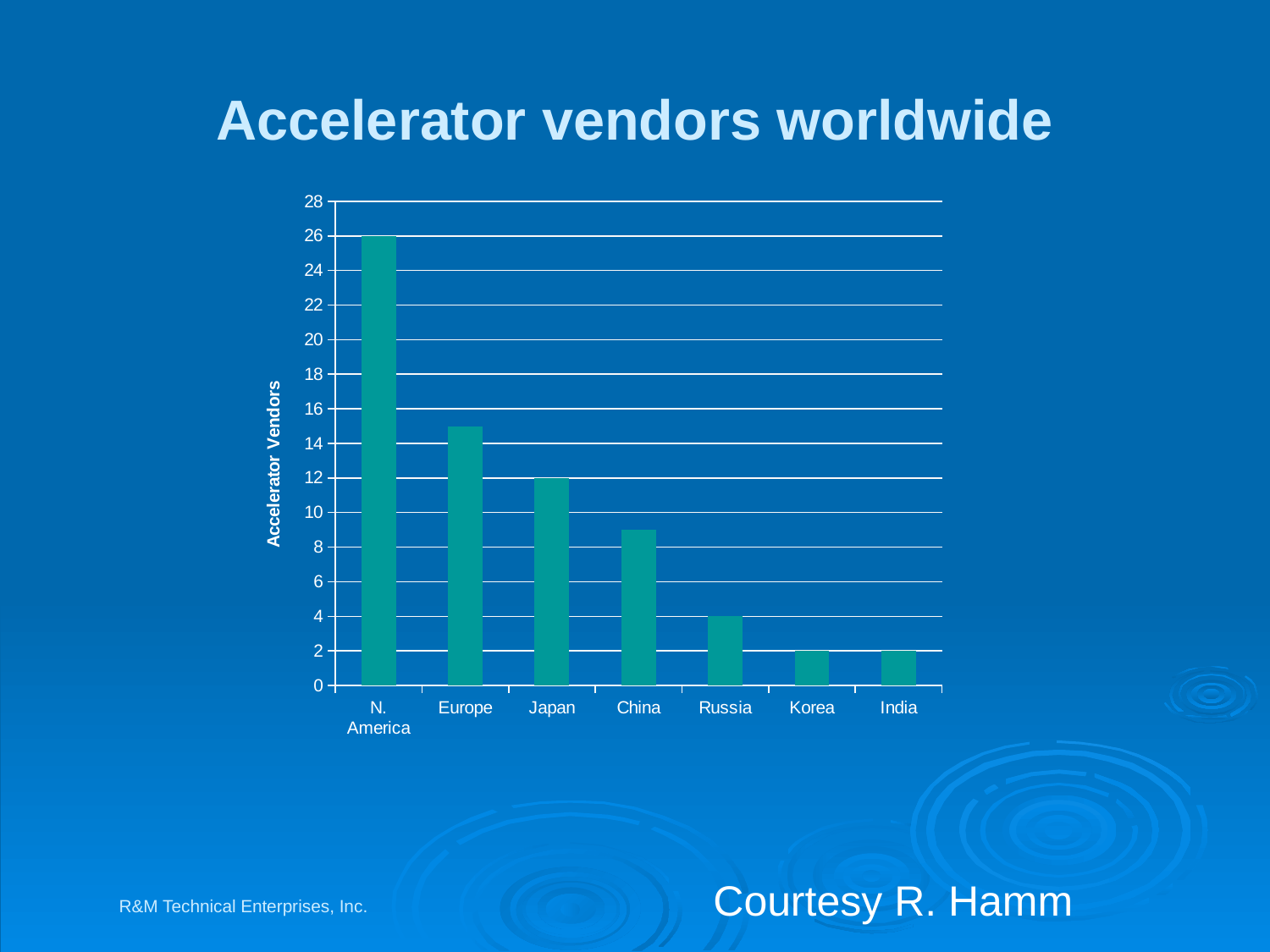
Do the values generally rise or fall moving from left to right along the x axis? fall Which region has the highest number of accelerator vendors? N. America How many accelerator vendors does Japan have? 12 How many accelerator vendors does N. America have? 26 What is the label on the y axis of the chart? Accelerator Vendors How many accelerator vendors does Russia have? 4 Which has more accelerator vendors, Europe or Japan? Europe Is the value for China greater or less than 10? less Is the value for Europe greater or less than 14? greater What kind of chart is shown on the slide? bar chart What is the difference between the number of accelerator vendors in N. America and Japan? 14 How many regions are shown on the x axis of the chart? 7